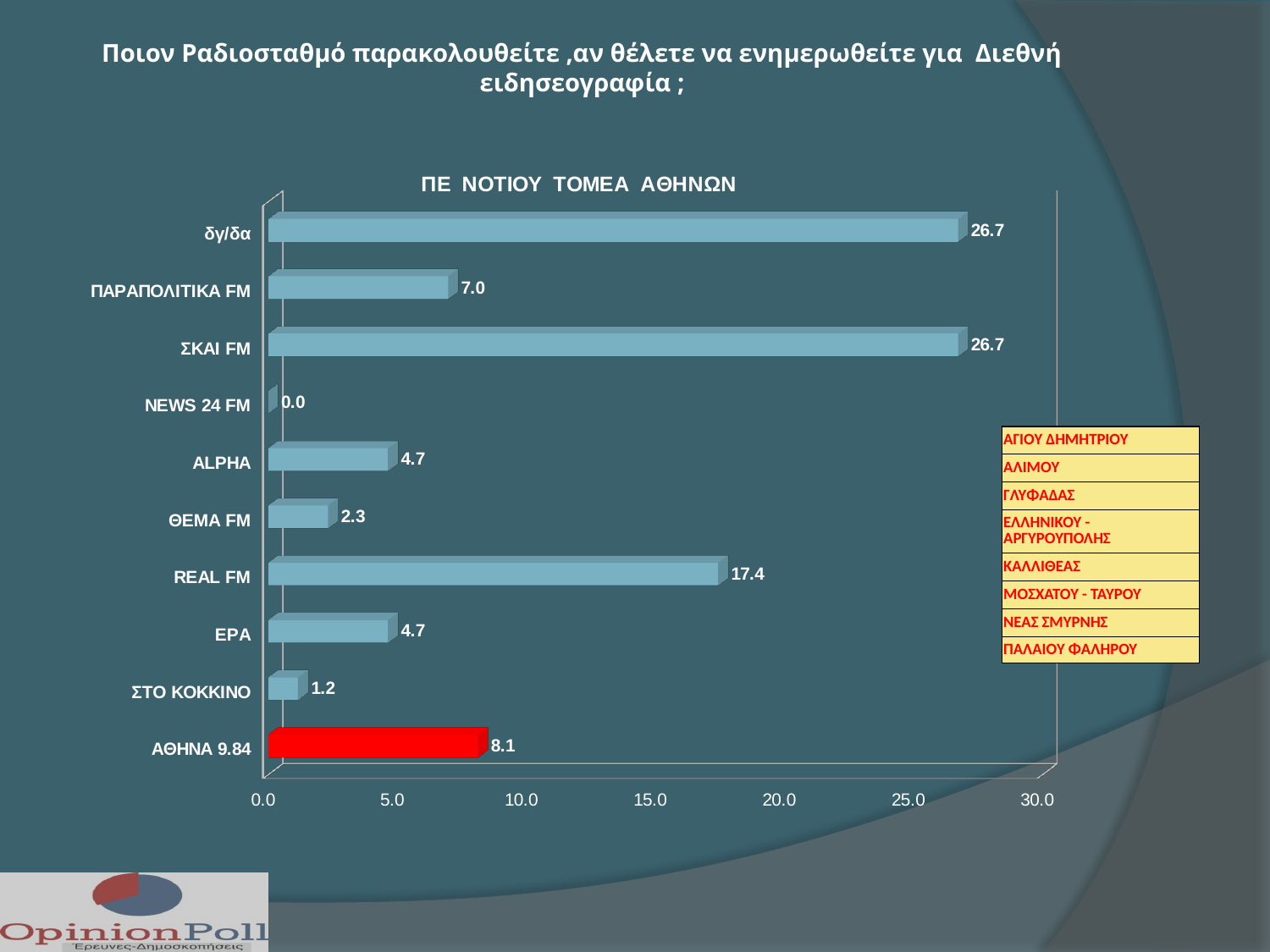
Which has a larger value, ALPHA or ΘΕΜΑ FM? ALPHA What is the title of the chart? ΠΕ ΝΟΤΙΟΥ ΤΟΜΕΑ ΑΘΗΝΩΝ Which radio station has the lowest value in the chart? NEWS 24 FM What value is shown for REAL FM? 17.4 What value is shown for ΠΑΡΑΠΟΛΙΤΙΚΑ FM? 7.0 What is the difference between the values for REAL FM and ΑΘΗΝΑ 9.84? 9.3 What kind of chart is shown on the slide? Bar chart What value is shown for ΣΤΟ ΚΟΚΚΙΝΟ? 1.2 What value is shown for ΑΘΗΝΑ 9.84? 8.1 What is the difference between the values for ΣΚΑΙ FM and ΠΑΡΑΠΟΛΙΤΙΚΑ FM? 19.7 Is the value for REAL FM greater or less than 15.0? greater How many radio station categories are shown in the chart? 10